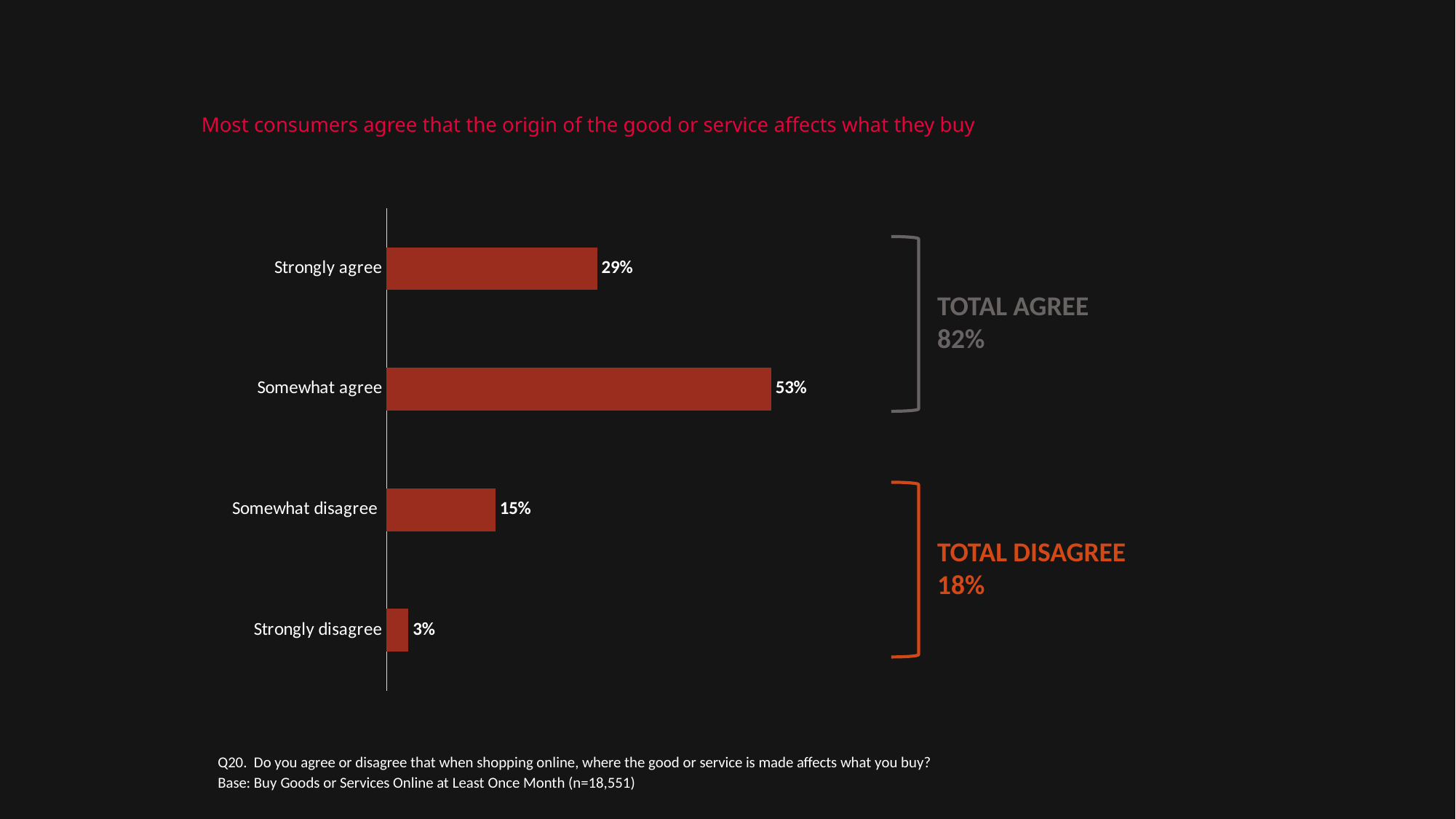
Which response category has the lowest percentage? Strongly disagree What is the difference between the Somewhat agree and Strongly agree percentages? 24% What is the Total Agree percentage shown on the slide? 82% Which is larger, the Somewhat disagree or the Strongly agree percentage? Strongly agree What percentage of respondents strongly agree? 29% How many response categories are shown in the chart? 4 What percentage of respondents strongly disagree? 3% What percentage of respondents somewhat disagree? 15% What type of chart is shown on the slide? Bar chart What is the Total Disagree percentage shown on the slide? 18% What percentage of respondents somewhat agree? 53% Which response category has the highest percentage? Somewhat agree